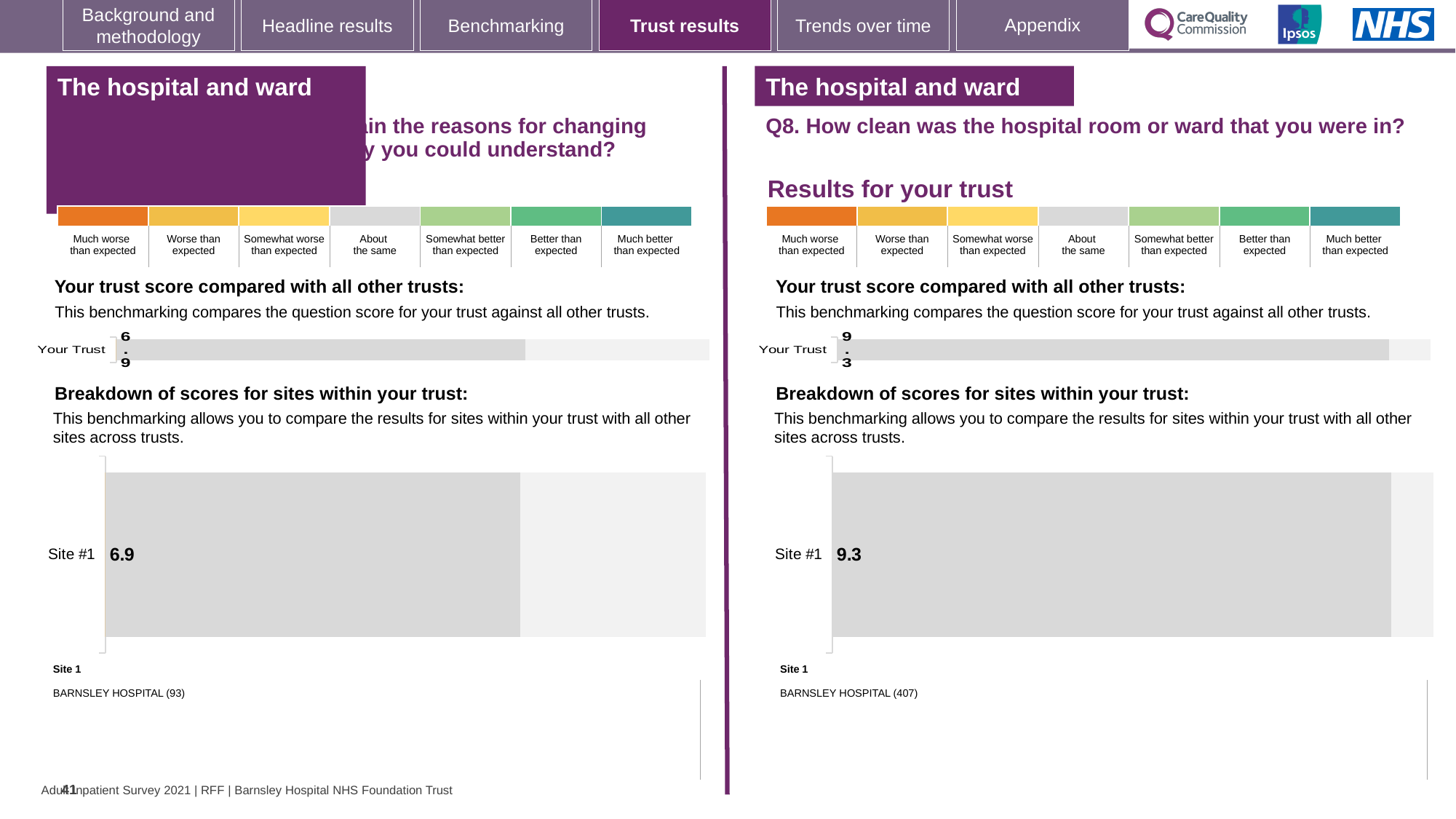
On the right-hand panel (Q8), what score is shown for Site #1 in the breakdown of scores for sites within your trust? 9.3 On the right-hand panel (Q8), which hospital is listed as Site 1 below the site breakdown chart? BARNSLEY HOSPITAL (407) What is the difference between the Site #1 score on the right-hand panel (Q8) and the Site #1 score on the left-hand panel? 2.4 What kind of chart is used to show the Your Trust score on the left-hand panel? Bar chart On the left-hand panel, which hospital is listed as Site 1 below the site breakdown chart? BARNSLEY HOSPITAL (93) Which is larger: the Your Trust score on the left-hand panel or the Your Trust score on the right-hand panel (Q8)? Right-hand panel (Q8) On the left-hand panel, what score is shown for Site #1 in the breakdown of scores for sites within your trust? 6.9 How many sites are shown in the breakdown of scores for sites within your trust on the left-hand panel? 1 On the left-hand panel, what is the score shown for Your Trust? 6.9 What kind of chart is used to show the Site #1 score on the right-hand panel (Q8)? Bar chart How many sites are shown in the breakdown of scores for sites within your trust on the right-hand panel (Q8)? 1 On the right-hand panel (Q8. How clean was the hospital room or ward that you were in?), what is the score shown for Your Trust? 9.3